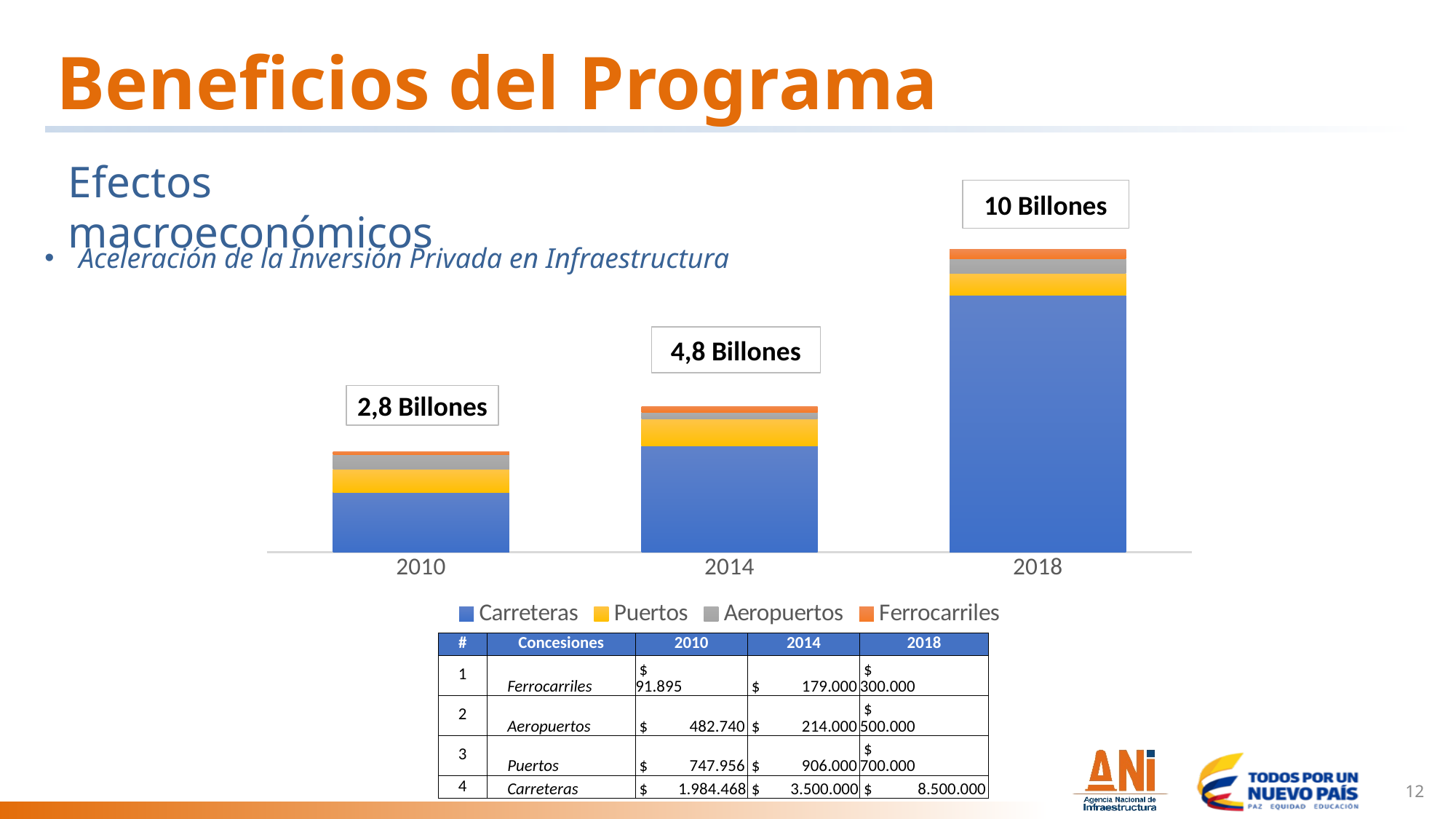
What total is labelled above the bar for 2010? 2,8 Billones Which series is shown in blue in the chart? Carreteras What is the difference between the labelled totals for 2018 and 2014? 5,2 Billones Which year has the tallest stacked bar? 2018 Which year has the shortest stacked bar? 2010 How many series does the chart legend list? 4 What total is labelled above the bar for 2014? 4,8 Billones How many years are shown on the x axis of the chart? 3 Which series is shown in orange in the chart? Ferrocarriles Do the bar totals rise or fall from 2010 to 2018? Rise What kind of chart is shown on the slide? Stacked bar chart What total is labelled above the bar for 2018? 10 Billones